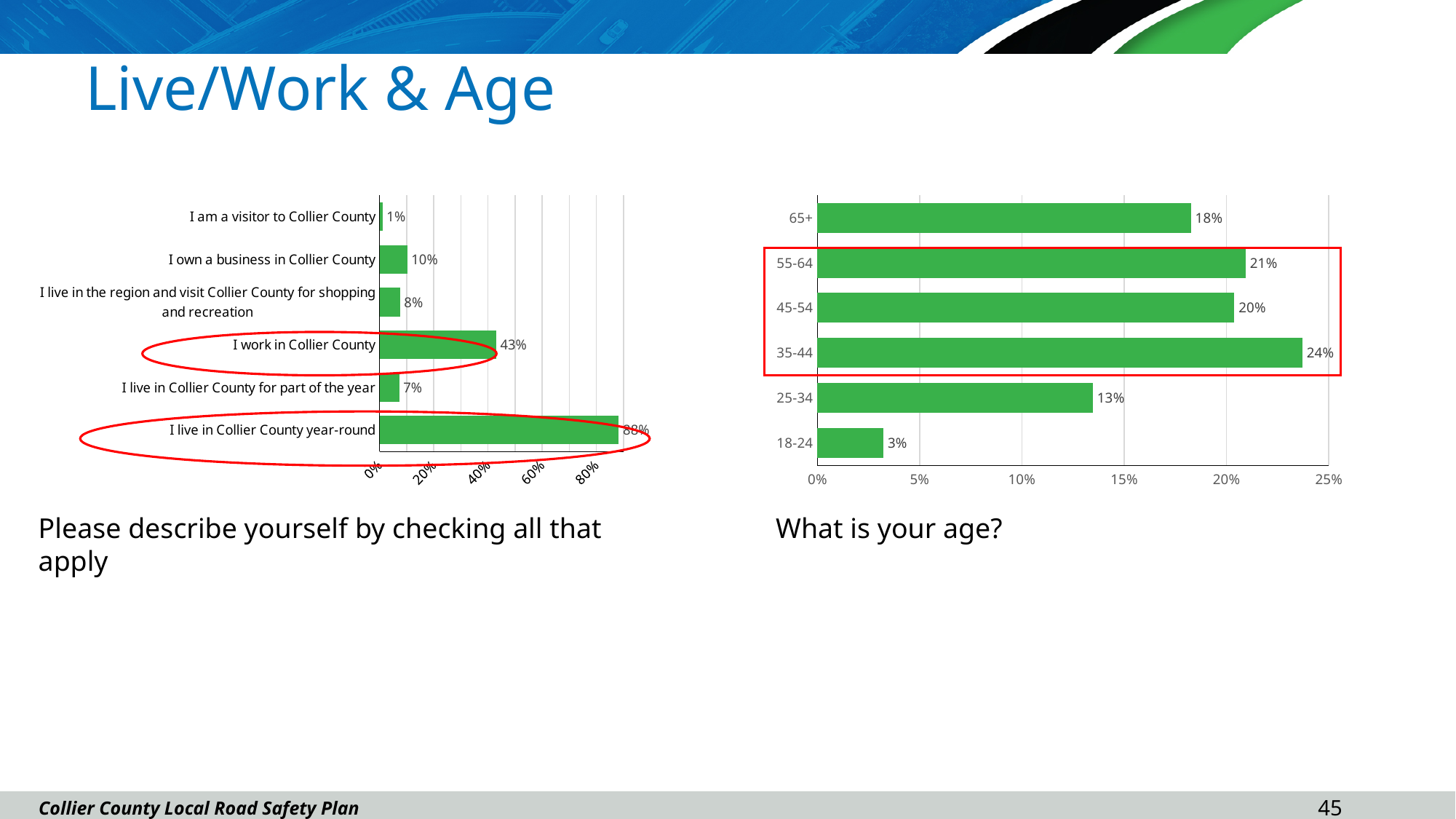
In the 'What is your age?' chart, which age group has the highest percentage? 35-44 In the 'Please describe yourself by checking all that apply' chart, what percentage of respondents work in Collier County? 43% What type of chart is the 'What is your age?' chart? Bar chart In the 'What is your age?' chart, which age group has the lowest percentage? 18-24 In the 'What is your age?' chart, how many age groups are shown? 6 In the 'What is your age?' chart, what percentage of respondents are aged 35-44? 24% In the 'Please describe yourself by checking all that apply' chart, what percentage of respondents own a business in Collier County? 10% In the 'Please describe yourself by checking all that apply' chart, is the value for 'I live in Collier County year-round' greater or less than 80%? greater In the 'What is your age?' chart, what is the difference between the 55-64 and 25-34 percentages? 8% In the 'Please describe yourself by checking all that apply' chart, which category has the lowest percentage? I am a visitor to Collier County In the 'Please describe yourself by checking all that apply' chart, which is larger: 'I live in Collier County for part of the year' or 'I live in the region and visit Collier County for shopping and recreation'? I live in the region and visit Collier County for shopping and recreation In the 'What is your age?' chart, what percentage of respondents are aged 18-24? 3%